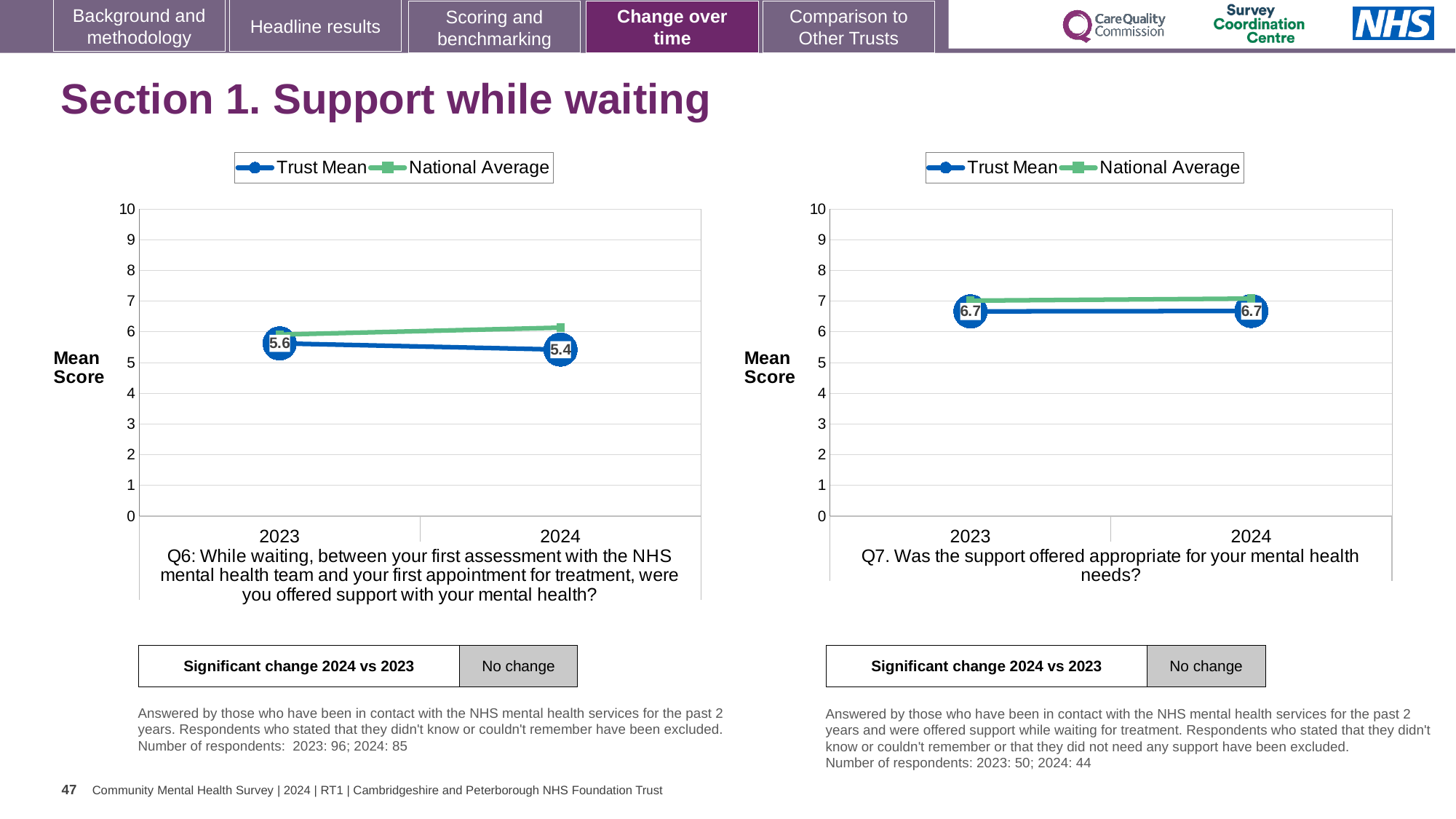
In the left chart (Q6), which year has the higher Trust Mean, 2023 or 2024? 2023 In the left chart (Q6), what is the difference between the Trust Mean in 2023 and in 2024? 0.2 How many series does the legend of the left chart (Q6) list? 2 In the right chart (Q7), does the Trust Mean rise, fall or stay the same from 2023 to 2024? stay the same What kind of chart is the right chart (Q7)? line chart In the left chart (Q6), does the Trust Mean rise or fall from 2023 to 2024? fall In the right chart (Q7), is the National Average for 2024 greater or less than 8? less In the right chart (Q7), which series is higher in 2024, Trust Mean or National Average? National Average In the left chart (Q6), what is the Trust Mean for 2024? 5.4 In the left chart (Q6), what is the Trust Mean for 2023? 5.6 In the left chart (Q6), is the National Average for 2024 greater or less than 5? greater In the right chart (Q7), what is the Trust Mean for 2024? 6.7